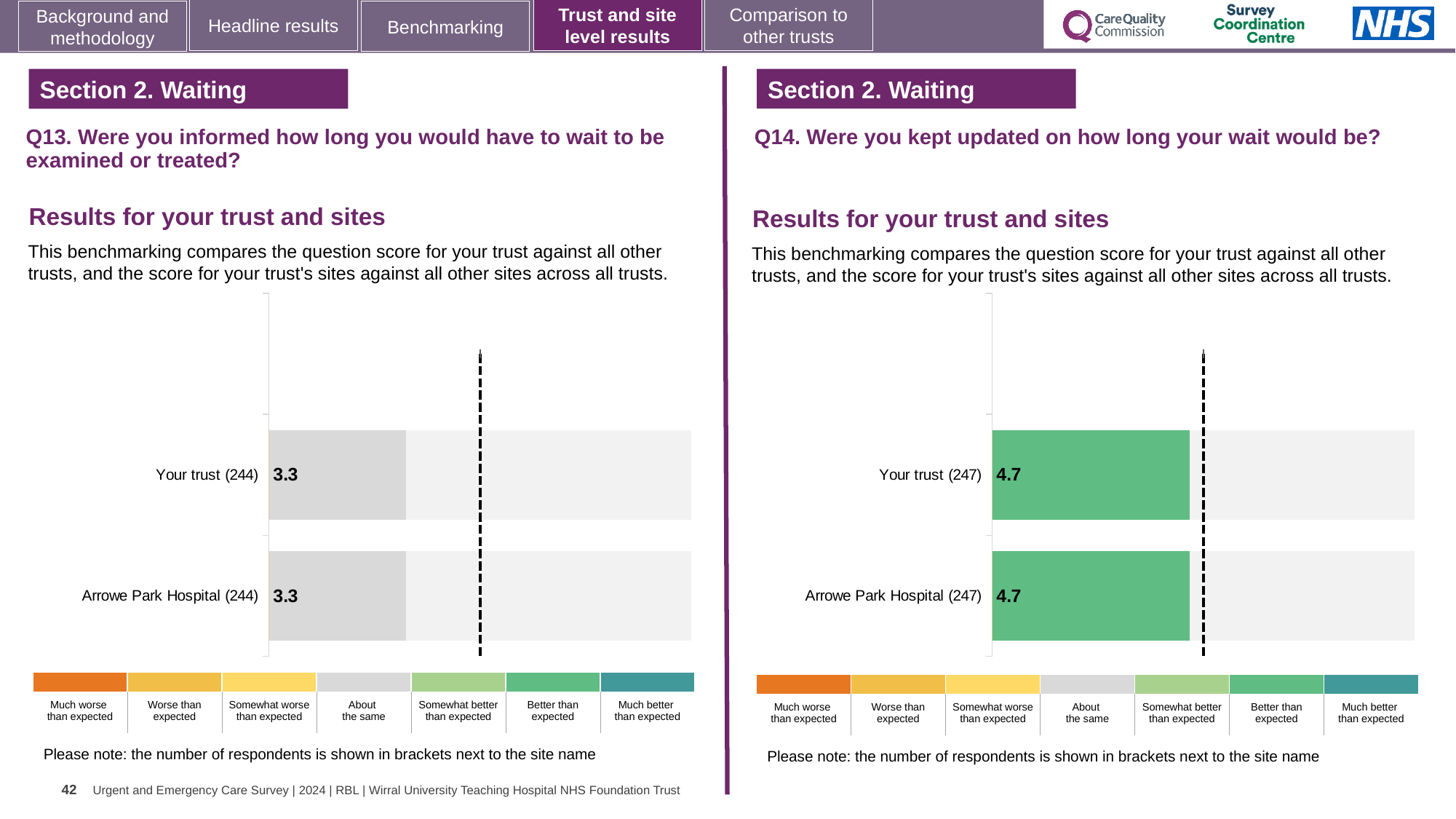
In the Q14 chart on the right, what is the score for Your trust (247)? 4.7 In the Q13 chart on the left, which benchmark category does the colour of the bars correspond to according to the legend? About the same In the Q13 chart on the left, what is the score for Arrowe Park Hospital (244)? 3.3 In the Q13 chart on the left, what is the score for Your trust (244)? 3.3 In the Q13 chart on the left, what is the difference between the score for Your trust and the score for Arrowe Park Hospital? 0 How many respondents are shown in brackets for Your trust in the Q14 chart on the right? 247 In the Q14 chart on the right, which benchmark category does the colour of the bars correspond to according to the legend? Better than expected How many bars are plotted in the Q13 chart on the left? 2 In the Q14 chart on the right, what is the score for Arrowe Park Hospital (247)? 4.7 In the Q14 chart on the right, what is the difference between the score for Your trust and the score for Arrowe Park Hospital? 0 What type of chart is used for the Q13 results on the left? Bar chart How many bars are plotted in the Q14 chart on the right? 2